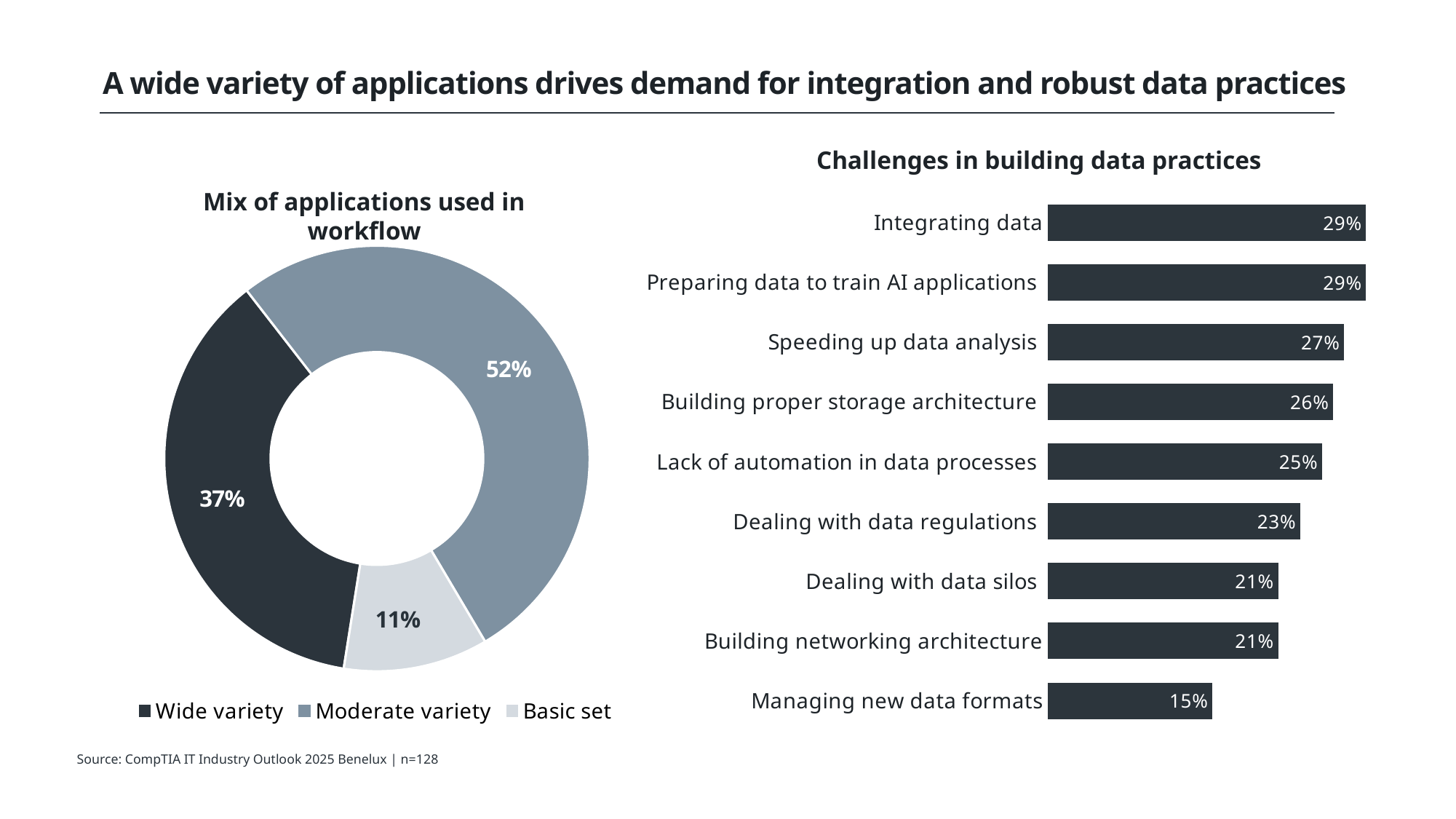
How many challenges are listed in the 'Challenges in building data practices' chart? 9 In the 'Mix of applications used in workflow' chart, which category has the largest share? Moderate variety In the 'Challenges in building data practices' chart, what is the value for Dealing with data regulations? 23% In the 'Challenges in building data practices' chart, what is the difference between Building proper storage architecture and Managing new data formats? 11 percentage points What kind of chart is 'Challenges in building data practices'? Bar chart In the 'Mix of applications used in workflow' chart, what share is labelled for Moderate variety? 52% In the 'Mix of applications used in workflow' chart, what share is labelled for Basic set? 11% In the 'Challenges in building data practices' chart, what is the value for Speeding up data analysis? 27% What kind of chart is 'Mix of applications used in workflow'? Doughnut chart In the 'Challenges in building data practices' chart, which is larger: Lack of automation in data processes or Dealing with data silos? Lack of automation in data processes In the 'Mix of applications used in workflow' chart, how many entries does the legend list? 3 In the 'Challenges in building data practices' chart, which challenge has the lowest value? Managing new data formats